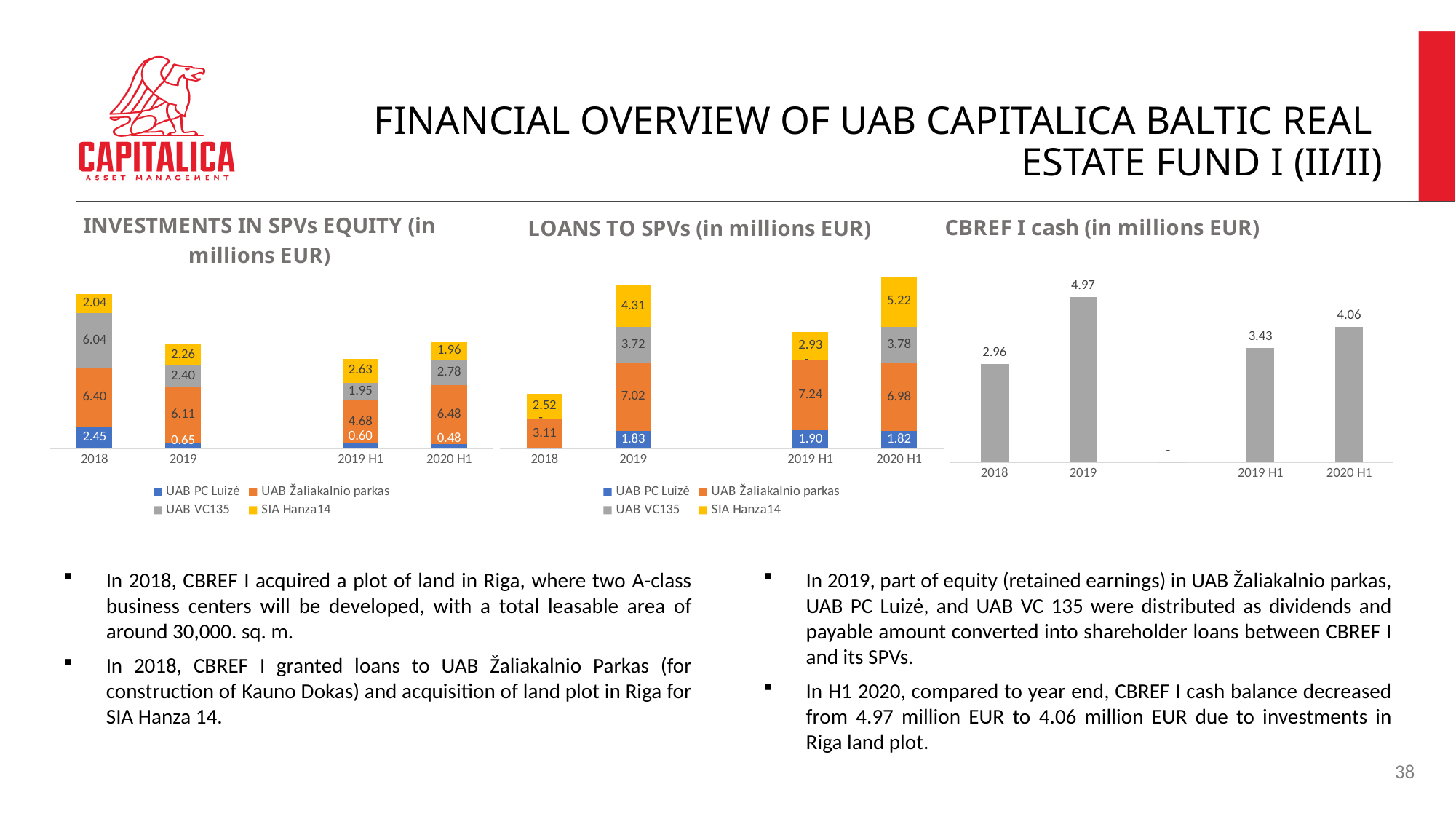
In the CBREF I cash chart, is the value for 2019 H1 greater or less than the value for 2020 H1? less In the LOANS TO SPVs chart, what is the total of the stacked bar for 2019? 16.88 In the INVESTMENTS IN SPVs EQUITY chart, which colour represents SIA Hanza14? Yellow In the LOANS TO SPVs chart, what is the value for SIA Hanza14 in 2020 H1? 5.22 In the LOANS TO SPVs chart, how many series does the legend list? 4 In the CBREF I cash chart, which year or period has the lowest cash value? 2018 In the INVESTMENTS IN SPVs EQUITY chart, what is the value for UAB PC Luizė in 2020 H1? 0.48 In the CBREF I cash chart, what is the value for 2019? 4.97 What type of chart is the CBREF I cash chart? Bar chart In the INVESTMENTS IN SPVs EQUITY chart, what is the value for UAB Žaliakalnio parkas in 2019? 6.11 In the INVESTMENTS IN SPVs EQUITY chart, what is the total of the stacked bar for 2018? 16.93 In the CBREF I cash chart, what is the difference between the 2019 value and the 2020 H1 value? 0.91